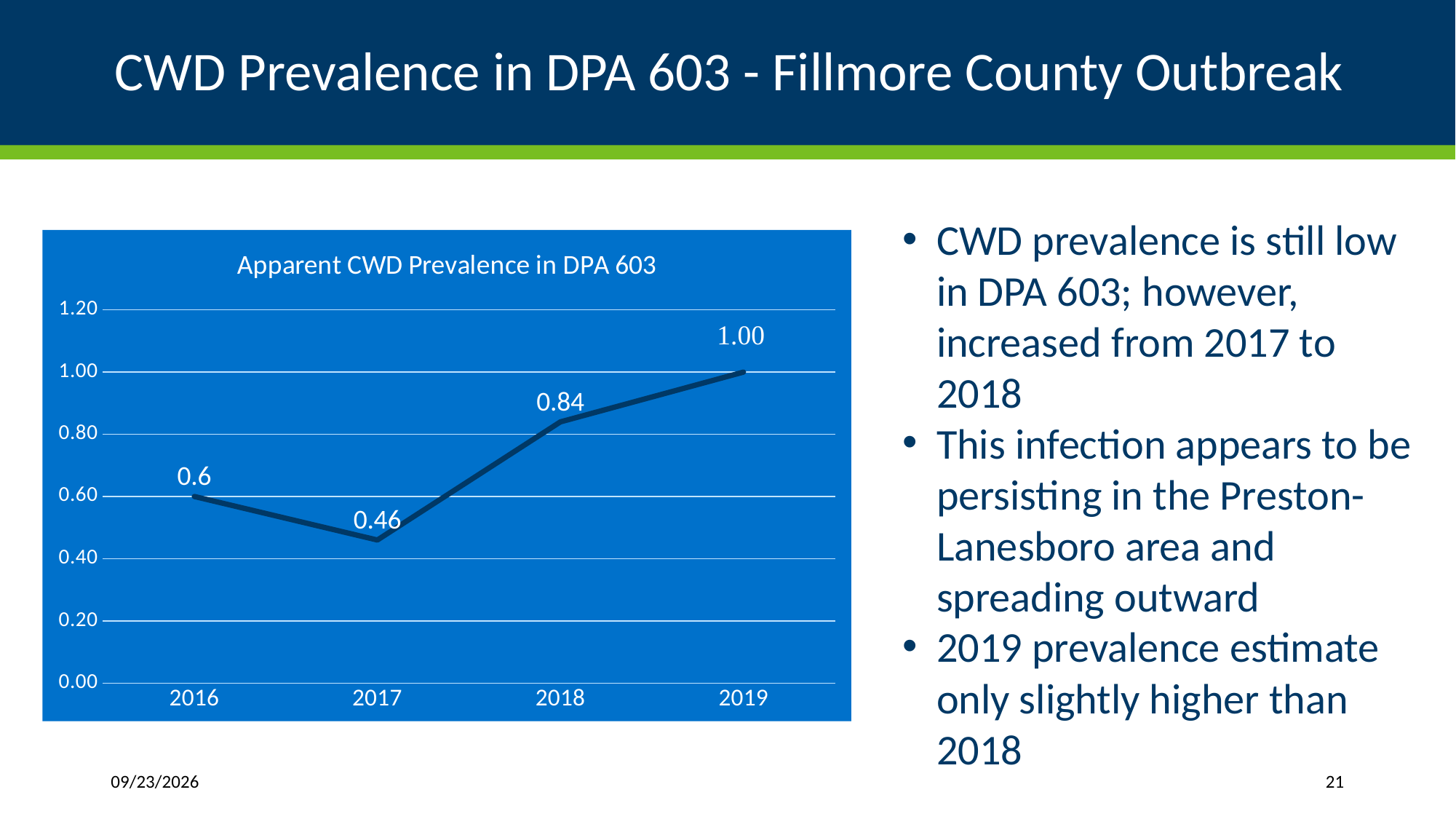
Is the apparent CWD prevalence for 2017 greater or less than 0.60? less What is the difference in apparent CWD prevalence between 2018 and 2017? 0.38 What kind of chart is shown on the slide? line chart Which year has a higher apparent CWD prevalence, 2016 or 2018? 2018 What is the apparent CWD prevalence in DPA 603 for 2018? 0.84 What is the apparent CWD prevalence in DPA 603 for 2019? 1.00 How many years are plotted in the chart? 4 What is the apparent CWD prevalence in DPA 603 for 2016? 0.6 What is the apparent CWD prevalence in DPA 603 for 2017? 0.46 Which year has the highest apparent CWD prevalence in DPA 603? 2019 What is the title of the chart? Apparent CWD Prevalence in DPA 603 Which year has the lowest apparent CWD prevalence in DPA 603? 2017